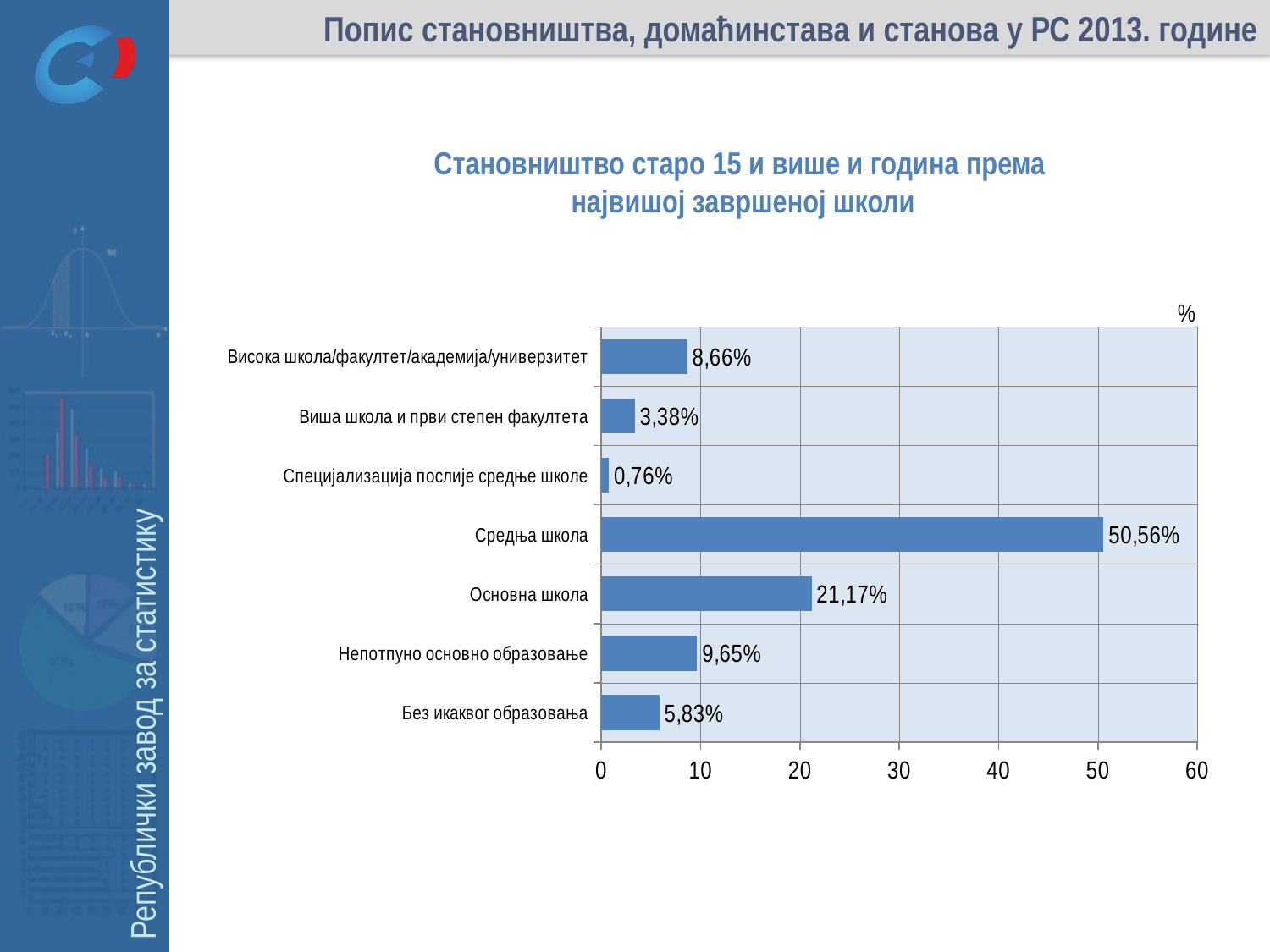
What is the value for Висока школа/факултет/академија/универзитет? 8,66% How many categories are shown in the chart? 7 What is the value for Без икаквог образовања? 5,83% What is the title of the chart? Становништво старо 15 и више и година према највишој завршеној школи What is the value for Основна школа? 21,17% Which category has the lowest value? Специјализација послије средње школе What kind of chart is shown on the slide? Bar chart What is the difference between the values for Средња школа and Основна школа? 29,39% Which category has the highest value? Средња школа What is the difference between the values for Непотпуно основно образовање and Без икаквог образовања? 3,82% What is the value for Средња школа? 50,56% Which is larger, the value for Виша школа и први степен факултета or the value for Без икаквог образовања? Без икаквог образовања